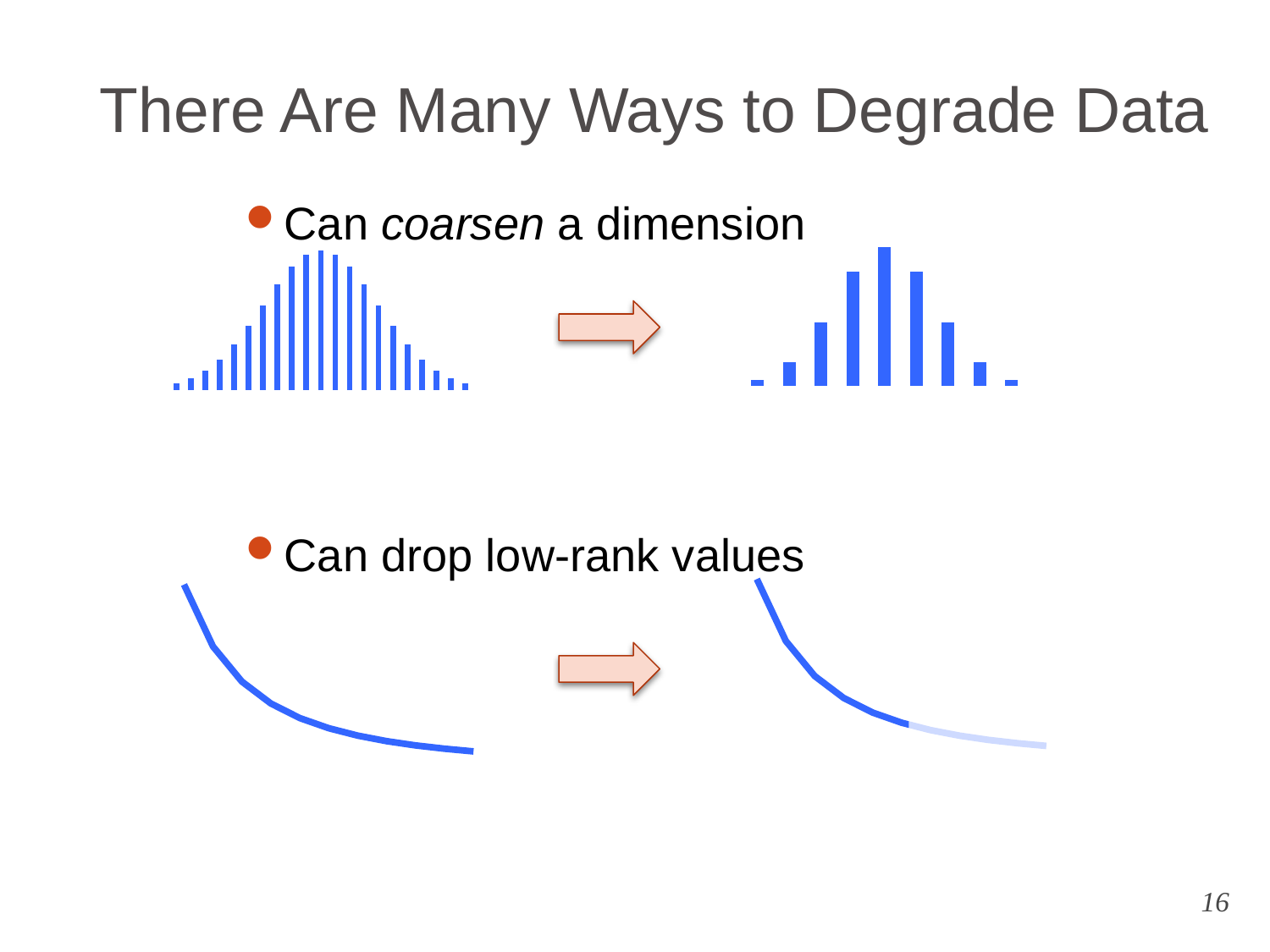
In the bottom-right line chart, do the values rise or fall from left to right? fall What kind of chart is the top-left chart under 'Can coarsen a dimension'? bar chart In the bottom-left line chart, do the values rise or fall from left to right? fall What kind of chart is the bottom-left chart under 'Can drop low-rank values'? line chart In the top-right bar chart, which bar is the tallest? the middle bar What colour are the bars in the top-left bar chart? blue How many bars are in the top-right bar chart? 9 What kind of chart is the top-right chart under 'Can coarsen a dimension'? bar chart In the top-left bar chart, do the bar heights rise or fall from the left edge to the middle? rise How many charts are shown on the slide? 4